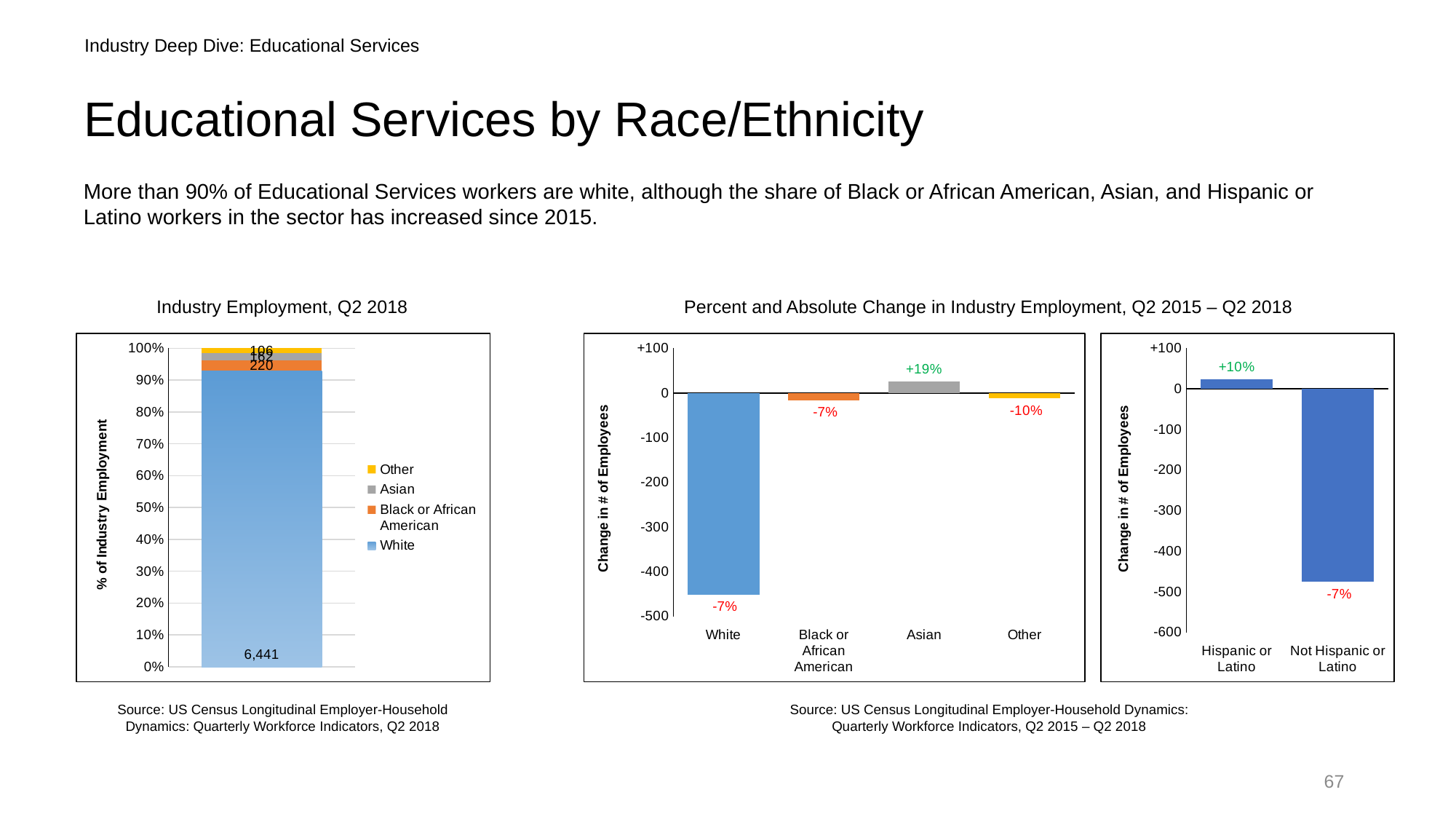
In the rightmost chart (change in employment by Hispanic or Latino status), what percent change is labelled for Hispanic or Latino? +10% In the middle chart (Percent and Absolute Change in Industry Employment by race), what percent change is labelled for Asian? +19% In the 'Industry Employment, Q2 2018' chart on the left, what value is labelled for Black or African American? 220 In the middle chart (Percent and Absolute Change in Industry Employment by race), which category has the lowest percent change? Other How many series does the legend of the 'Industry Employment, Q2 2018' chart on the left list? 4 In the 'Industry Employment, Q2 2018' chart on the left, what value is labelled for White? 6,441 How many categories are shown on the x axis of the middle chart (Percent and Absolute Change in Industry Employment by race)? 4 In the rightmost chart (change in employment by Hispanic or Latino status), is the change in number of employees for Not Hispanic or Latino greater or less than -400? less In the middle chart (Percent and Absolute Change in Industry Employment by race), is the change in number of employees for White greater or less than -400? less What kind of chart is the 'Industry Employment, Q2 2018' chart on the left? Stacked bar chart In the middle chart (Percent and Absolute Change in Industry Employment by race), what percent change is labelled for Other? -10% In the middle chart (Percent and Absolute Change in Industry Employment by race), which category has the highest percent change? Asian